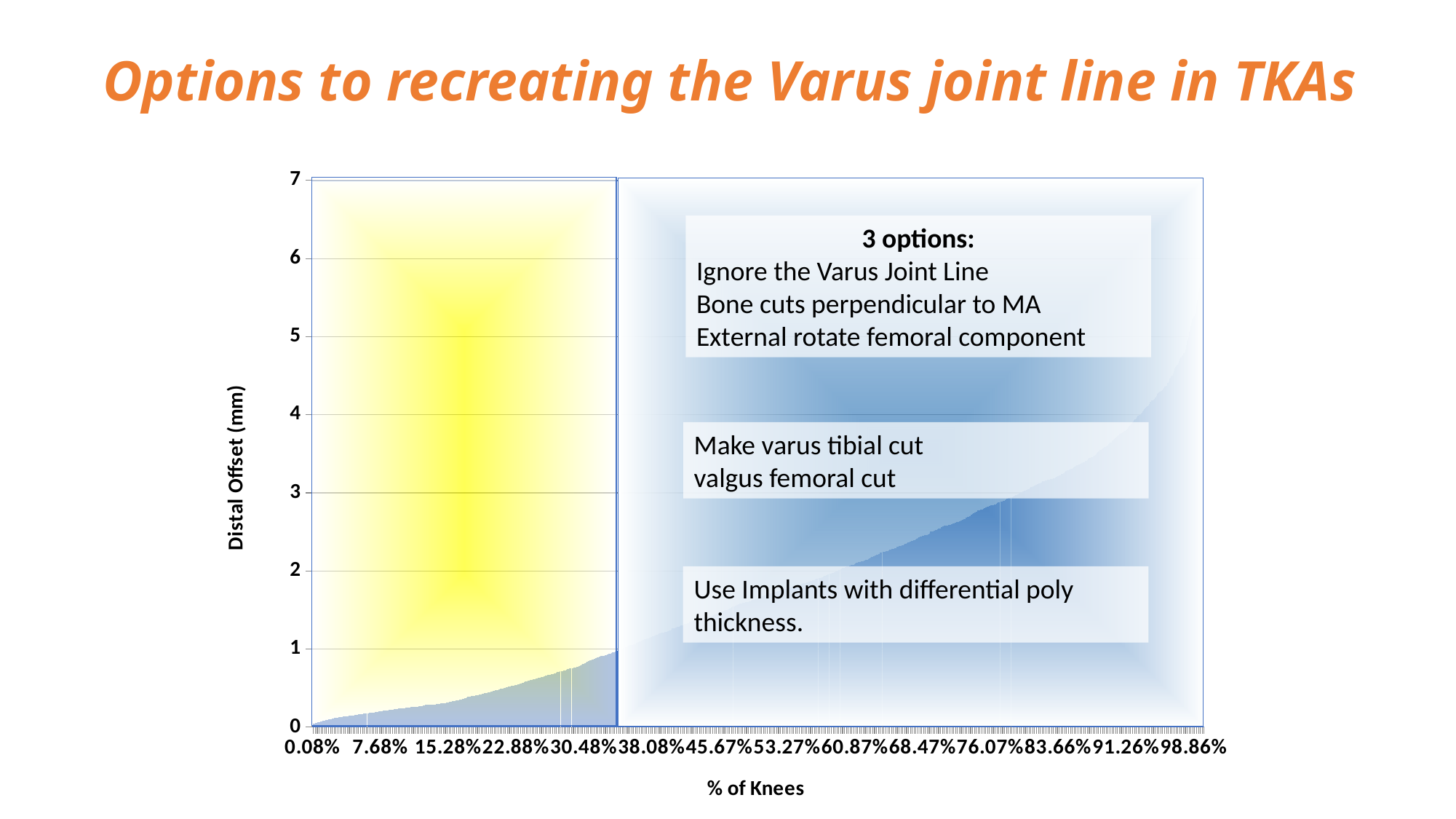
Is the value for 53.27% greater or less than 3? less What is the title of the vertical axis on the chart? Distal Offset (mm) What is the title of the horizontal axis on the chart? % of Knees Which has the larger Distal Offset value, 22.88% or 76.07%? 76.07% Is the value for 0.08% greater or less than 1? less Is the value for 38.08% greater or less than 2? less Which x-axis category has the lowest Distal Offset value? 0.08% Do the plotted values rise or fall as you move from left to right along the x axis? rise Which x-axis category has the highest Distal Offset value? 98.86% How many tick labels are shown on the x axis? 14